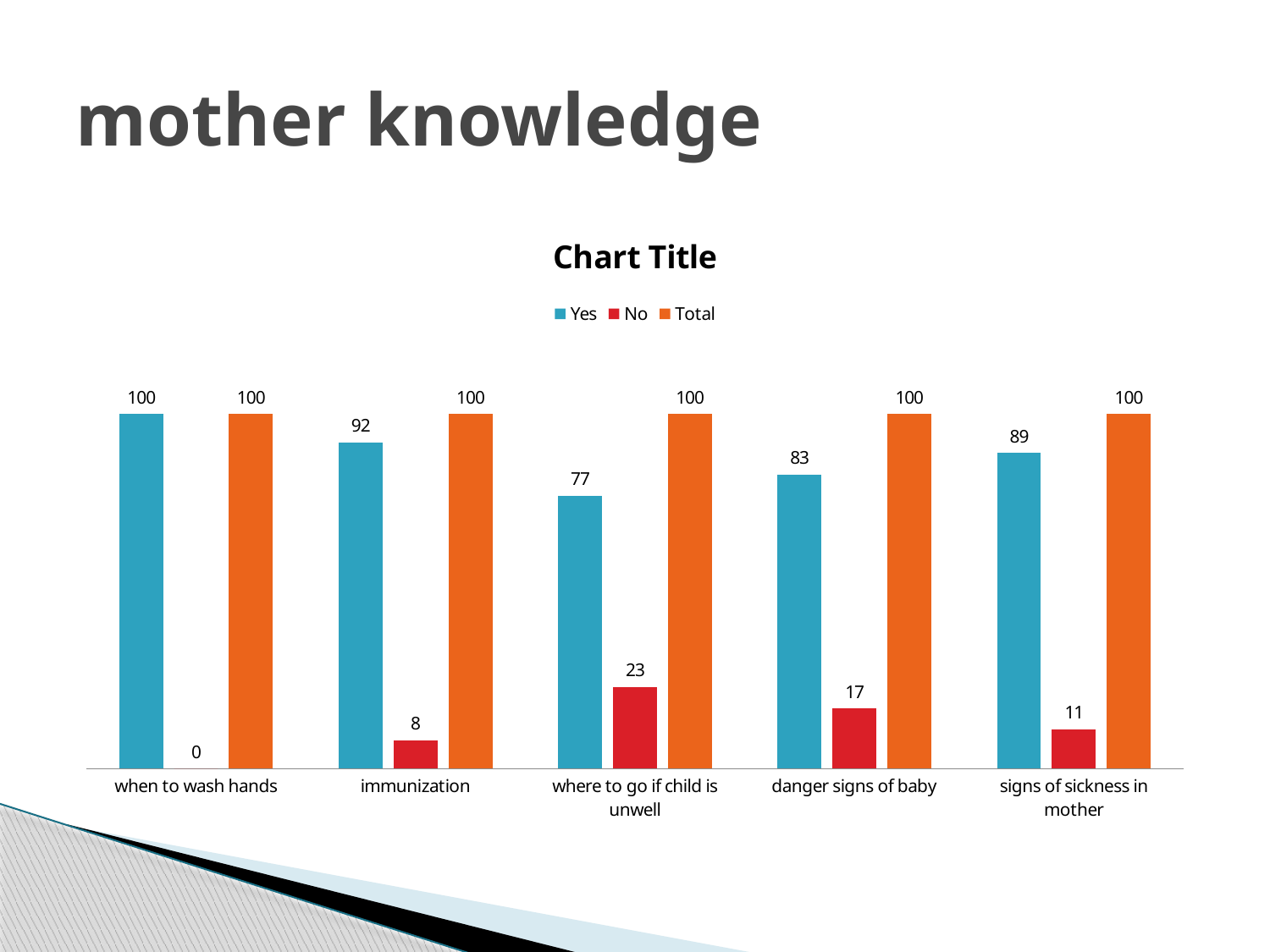
What is the No value for when to wash hands? 0 What kind of chart is shown on the slide? bar chart How many series does the legend list? 3 Which category has the lowest Yes value? where to go if child is unwell How many categories are shown on the x axis? 5 Which category has the highest No value? where to go if child is unwell What is the No value for where to go if child is unwell? 23 What is the difference between the Yes values for immunization and signs of sickness in mother? 3 What is the Yes value for danger signs of baby? 83 What is the title of the chart? Chart Title Which is larger, the No value for danger signs of baby or the No value for signs of sickness in mother? danger signs of baby What is the Yes value for immunization? 92